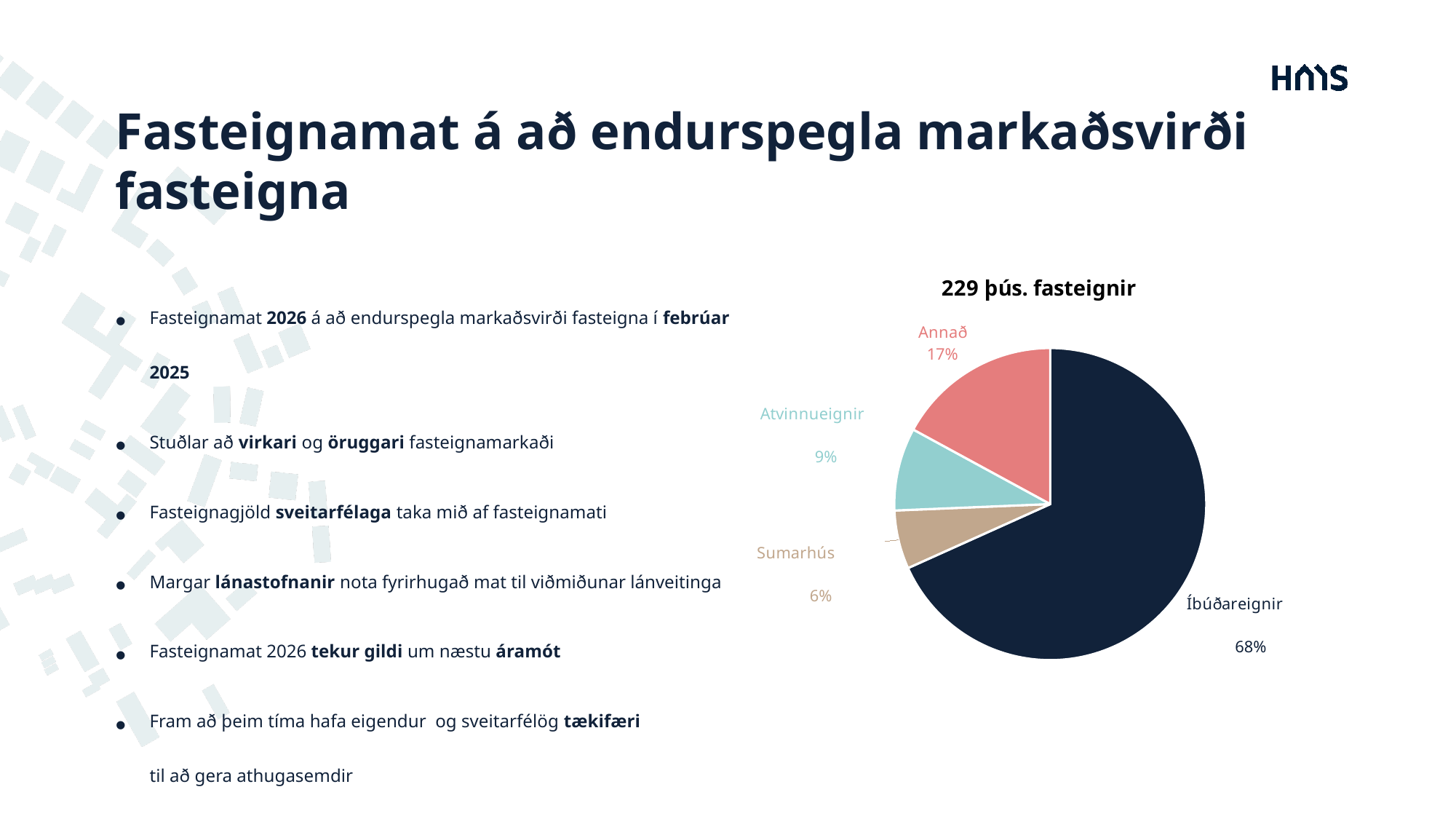
Which category has the largest slice of the pie? Íbúðareignir What is the title of the chart? 229 þús. fasteignir What is the difference in percentage points between Íbúðareignir and Annað? 51 Which is larger, the share for Atvinnueignir or the share for Sumarhús? Atvinnueignir What share of the pie does Atvinnueignir have? 9% What share of the pie does Íbúðareignir have? 68% How many slices does the pie chart have? 4 Which category has the smallest slice of the pie? Sumarhús What share of the pie does Sumarhús have? 6% What share of the pie does Annað have? 17% What kind of chart is shown on the slide? pie chart What colour is the Íbúðareignir slice? dark navy blue